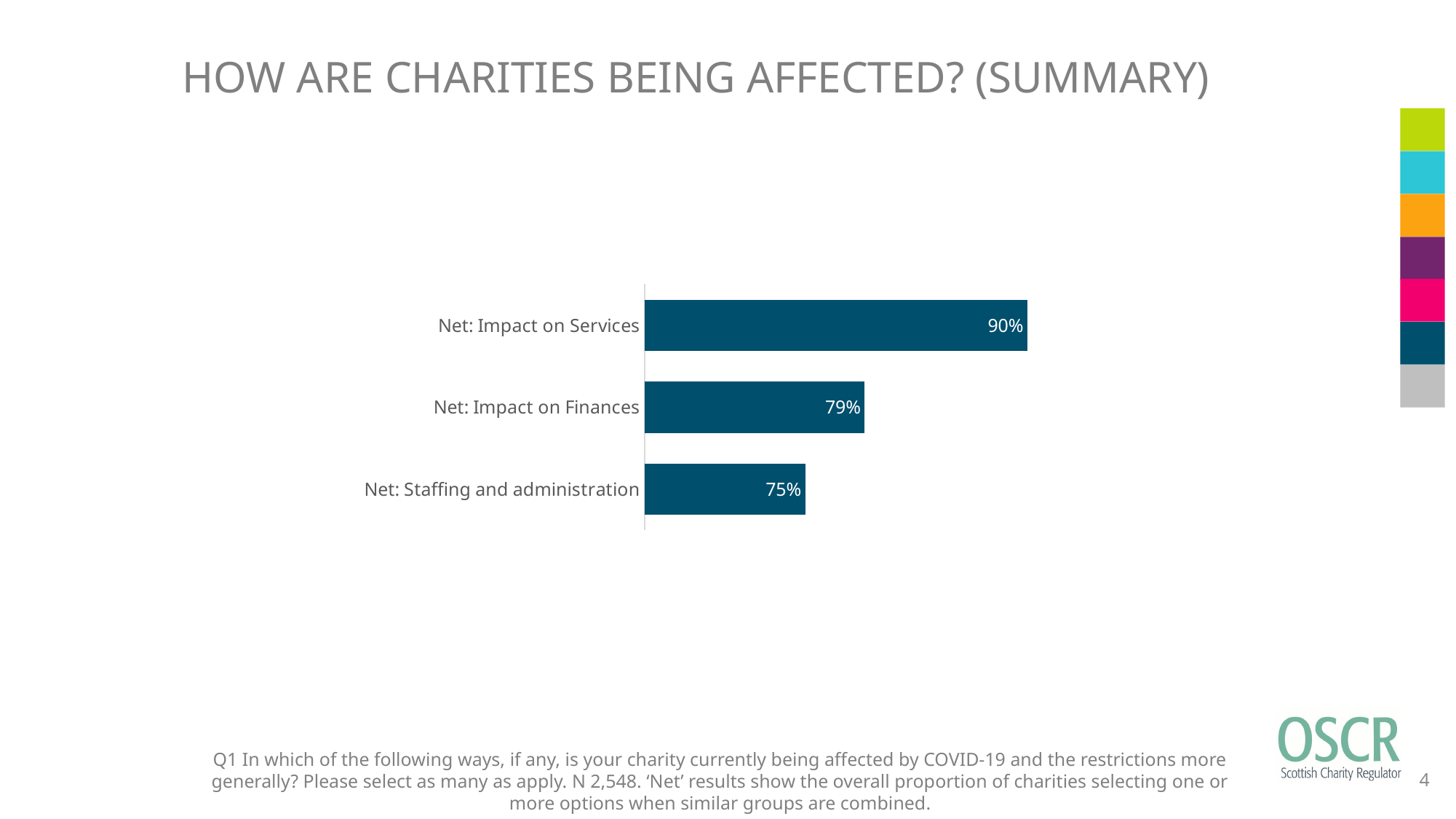
What is the title of the slide containing the chart? HOW ARE CHARITIES BEING AFFECTED? (SUMMARY) Which category has the lowest value? Net: Staffing and administration What is the value for Net: Staffing and administration? 75% What is the difference between Net: Impact on Finances and Net: Staffing and administration? 4% What is the sample size (N) stated in the footnote below the chart? 2,548 What is the value for Net: Impact on Services? 90% Which is larger, Net: Impact on Finances or Net: Staffing and administration? Net: Impact on Finances What is the difference between Net: Impact on Services and Net: Impact on Finances? 11% Which category has the highest value? Net: Impact on Services What is the value for Net: Impact on Finances? 79% What kind of chart is shown on the slide? Bar chart How many categories are shown in the chart? 3